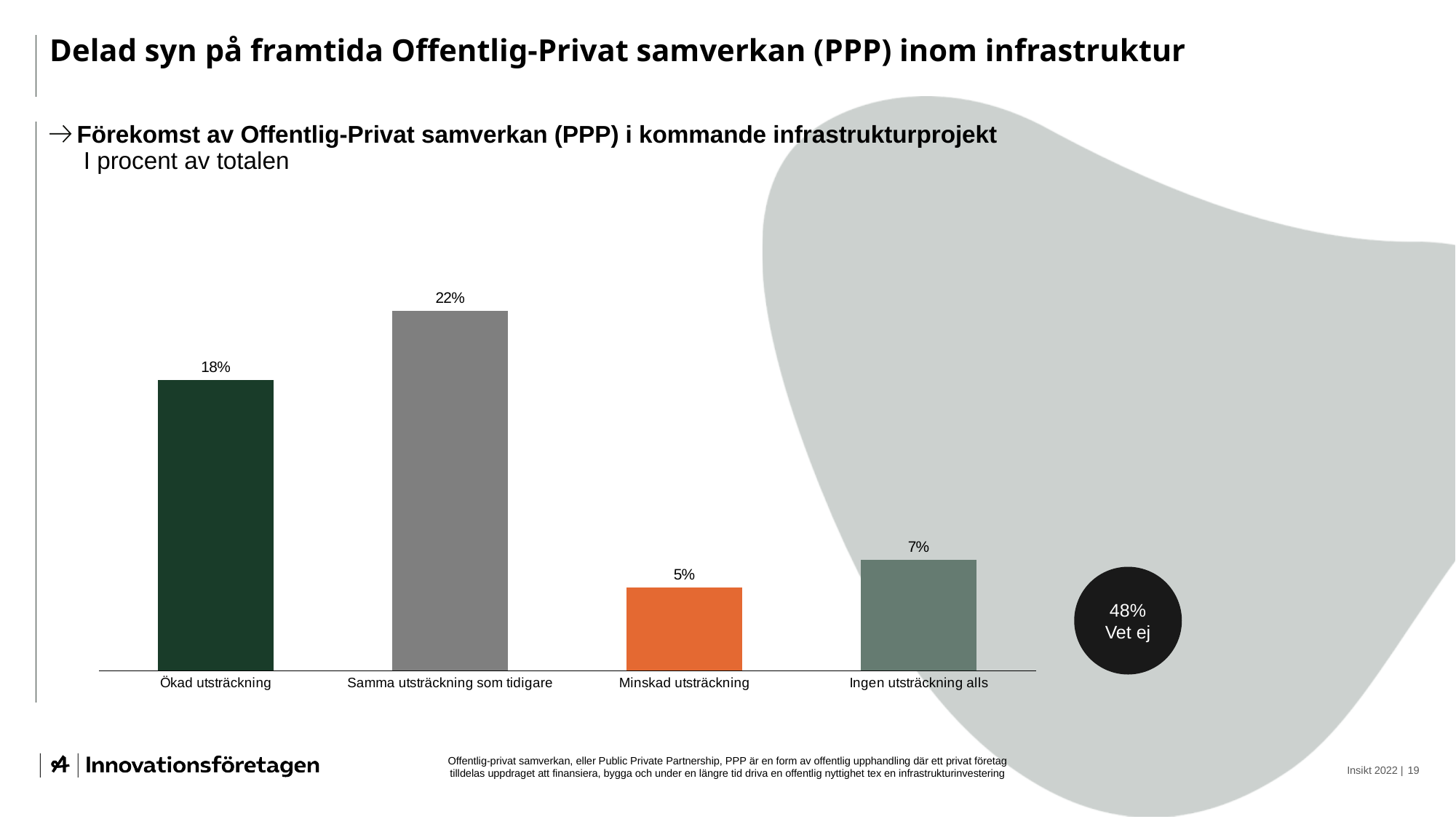
What is the difference between "Samma utsträckning som tidigare" and "Ökad utsträckning"? 4% Which category has the highest value? Samma utsträckning som tidigare What is the value for "Minskad utsträckning"? 5% What percentage answered "Vet ej" according to the circle next to the chart? 48% What kind of chart is shown on the slide? Bar chart How many categories are shown on the bar chart? 4 What colour is the bar for "Minskad utsträckning"? Orange Which is larger, "Ingen utsträckning alls" or "Minskad utsträckning"? Ingen utsträckning alls What is the value for "Ingen utsträckning alls"? 7% What is the value for "Ökad utsträckning"? 18% What is the value for "Samma utsträckning som tidigare"? 22% Which category has the lowest value? Minskad utsträckning